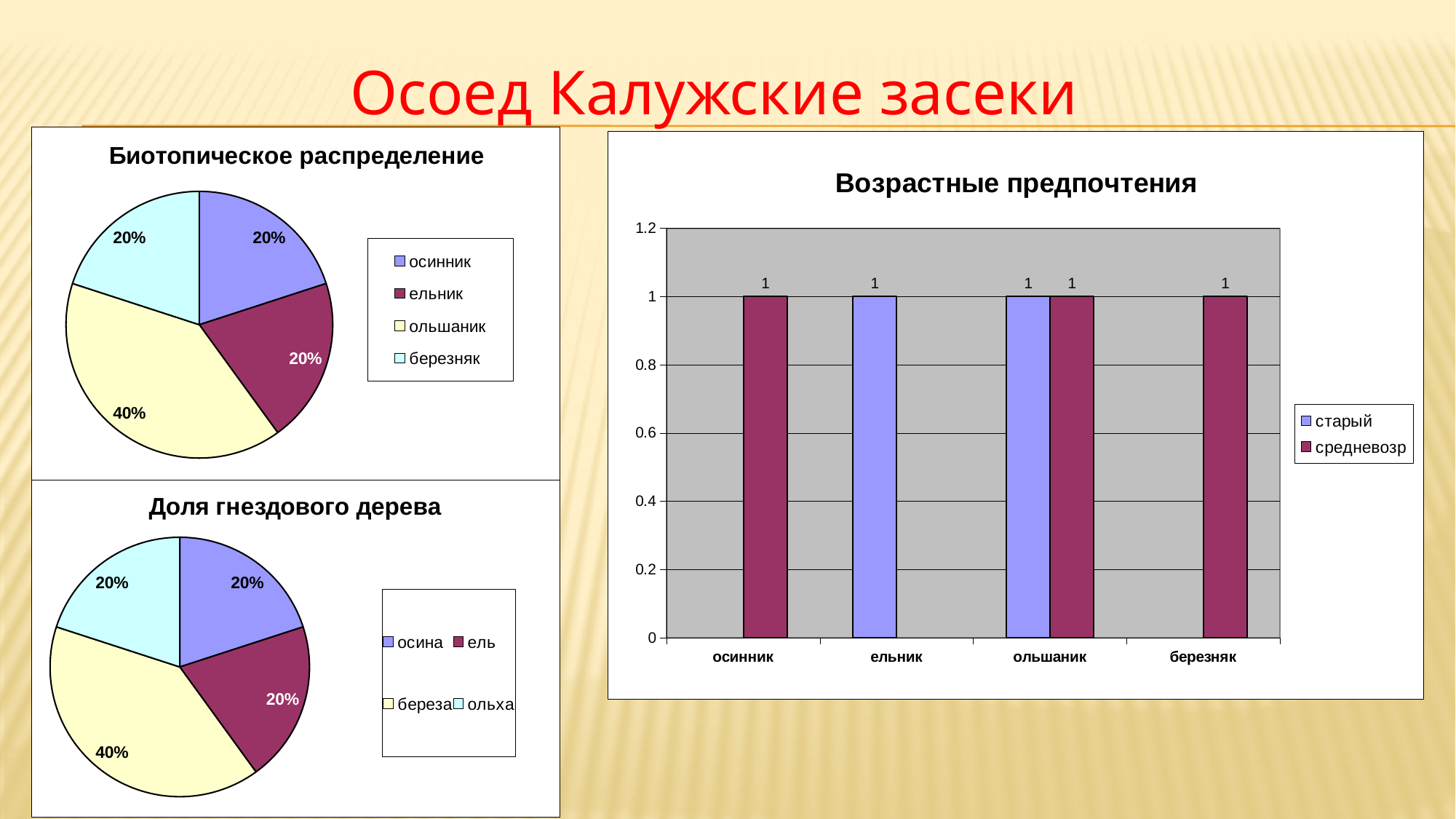
In the chart titled 'Возрастные предпочтения', how many categories are shown on the x axis? 4 What kind of chart is 'Возрастные предпочтения'? bar chart In the chart titled 'Возрастные предпочтения', how many series does the legend list? 2 In the chart titled 'Биотопическое распределение', what share does ольшаник have? 40% In the chart titled 'Биотопическое распределение', which category has the largest share? ольшаник In the chart titled 'Возрастные предпочтения', what is the value of средневозр for осинник? 1 In the chart titled 'Доля гнездового дерева', what is the difference between the shares of береза and осина? 20% In the chart titled 'Доля гнездового дерева', what share does береза have? 40% In the chart titled 'Доля гнездового дерева', what share does ель have? 20% In the chart titled 'Возрастные предпочтения', which category has bars for both старый and средневозр? ольшаник In the chart titled 'Биотопическое распределение', how many categories does the legend list? 4 What kind of chart is 'Биотопическое распределение'? pie chart